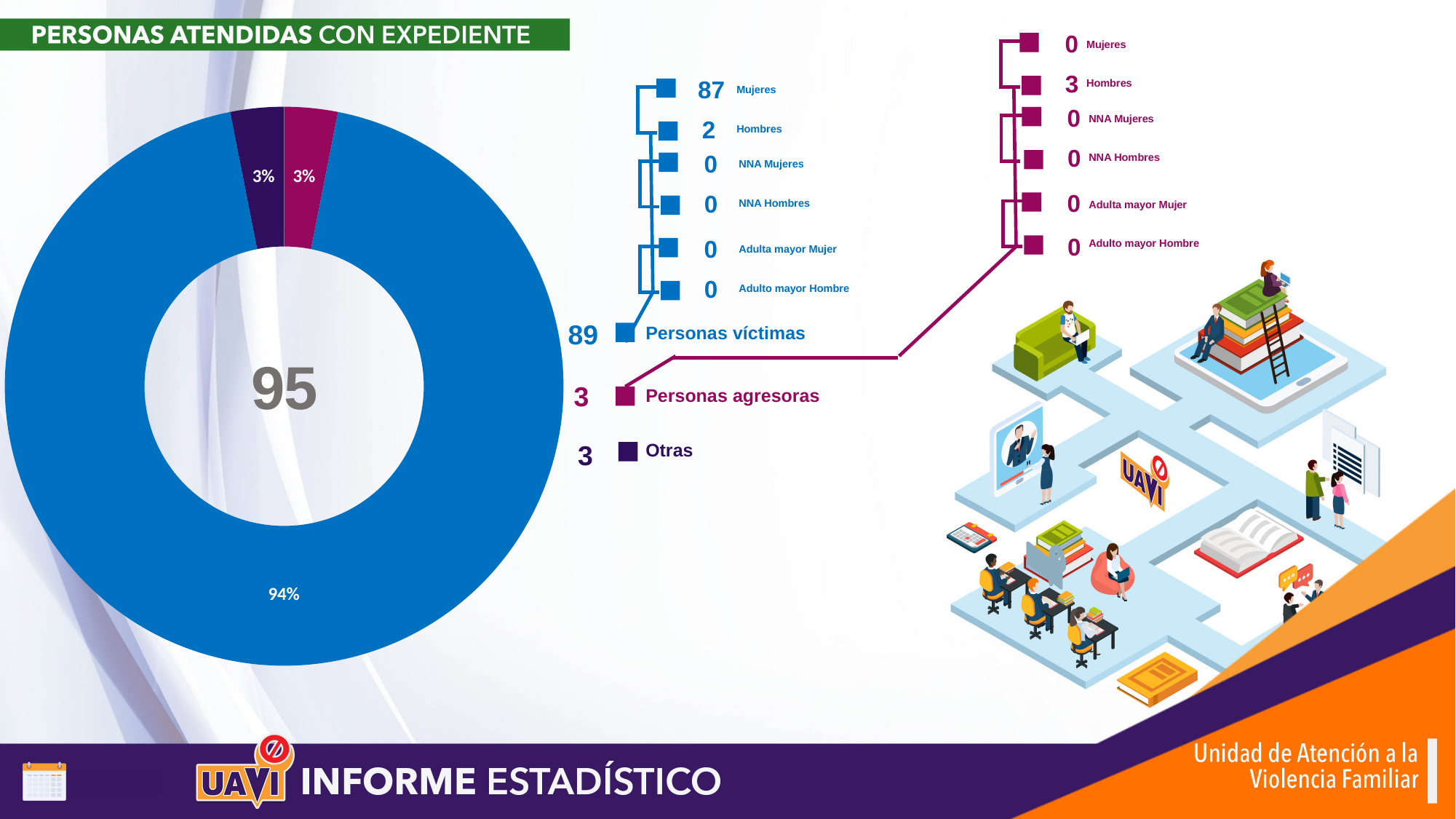
What percentage of the donut chart does Personas agresoras represent? 3% What percentage of the donut chart does Personas víctimas represent? 94% How many Personas víctimas are reported in the legend? 89 What kind of chart is shown on the slide? Donut (pie) chart What is the total number shown in the centre of the donut chart? 95 How many Personas agresoras are reported in the legend? 3 What is the difference between the number of Personas víctimas and Personas agresoras? 86 In the breakdown of Personas víctimas, how many are Mujeres? 87 How many Otras are reported in the legend? 3 How many categories does the donut chart legend list? 3 In the breakdown of Personas agresoras, how many are Hombres? 3 Which category has the largest slice of the donut chart? Personas víctimas